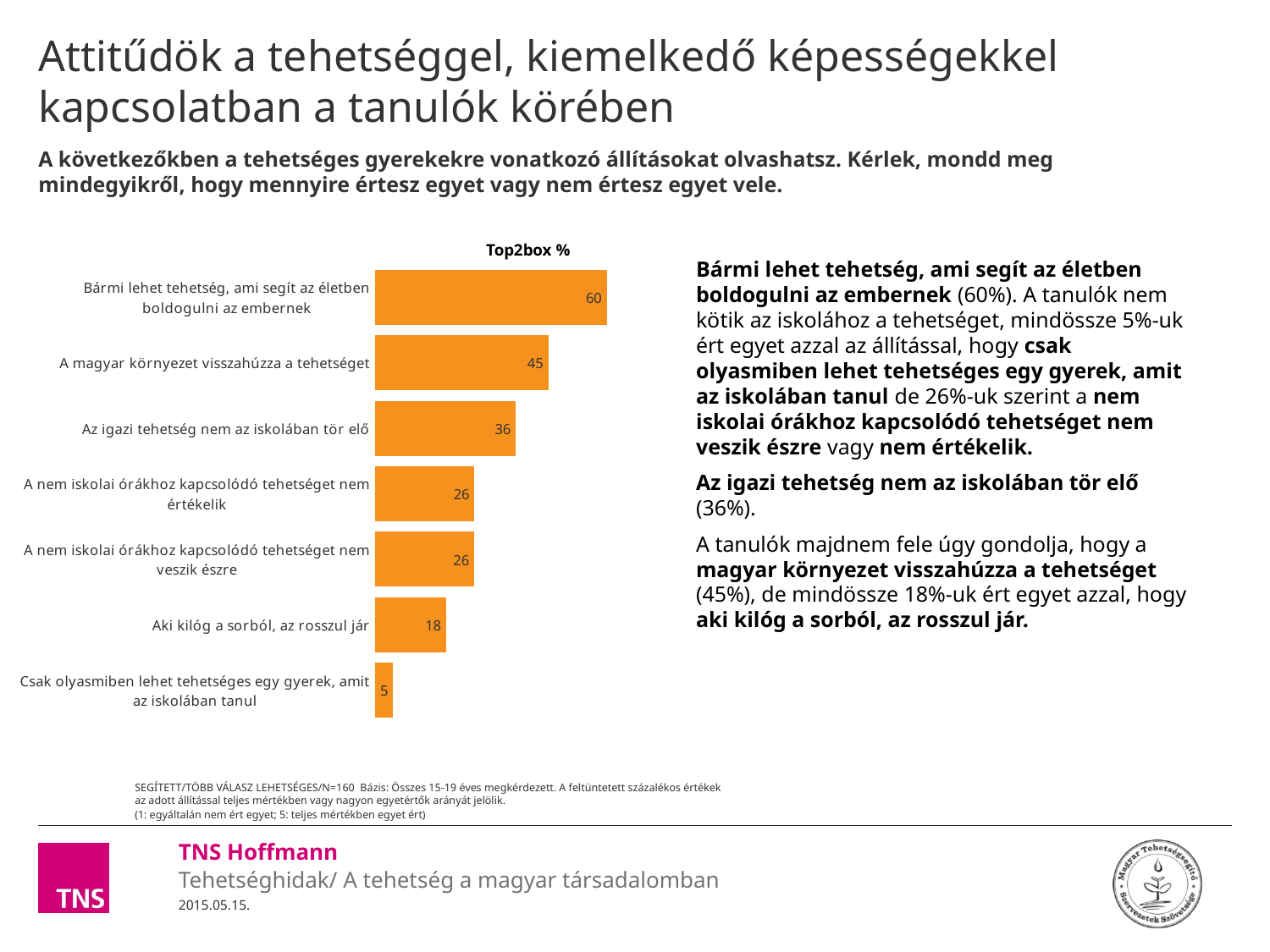
What kind of chart is shown on the slide? Bar chart Which statement has the highest Top2box % value? Bármi lehet tehetség, ami segít az életben boldogulni az embernek Which has a larger Top2box % value: "A magyar környezet visszahúzza a tehetséget" or "Aki kilóg a sorból, az rosszul jár"? A magyar környezet visszahúzza a tehetséget What is the title of the chart? Top2box % Which statement has the lowest Top2box % value? Csak olyasmiben lehet tehetséges egy gyerek, amit az iskolában tanul What is the difference between the Top2box % values for "A magyar környezet visszahúzza a tehetséget" and "Csak olyasmiben lehet tehetséges egy gyerek, amit az iskolában tanul"? 40 What is the Top2box % value for "A nem iskolai órákhoz kapcsolódó tehetséget nem értékelik"? 26 What is the Top2box % value for "A magyar környezet visszahúzza a tehetséget"? 45 How many statements (bars) are shown in the chart? 7 What is the Top2box % value for "Aki kilóg a sorból, az rosszul jár"? 18 What is the difference between the Top2box % values for "Bármi lehet tehetség, ami segít az életben boldogulni az embernek" and "Az igazi tehetség nem az iskolában tör elő"? 24 What is the Top2box % value for "Bármi lehet tehetség, ami segít az életben boldogulni az embernek"? 60